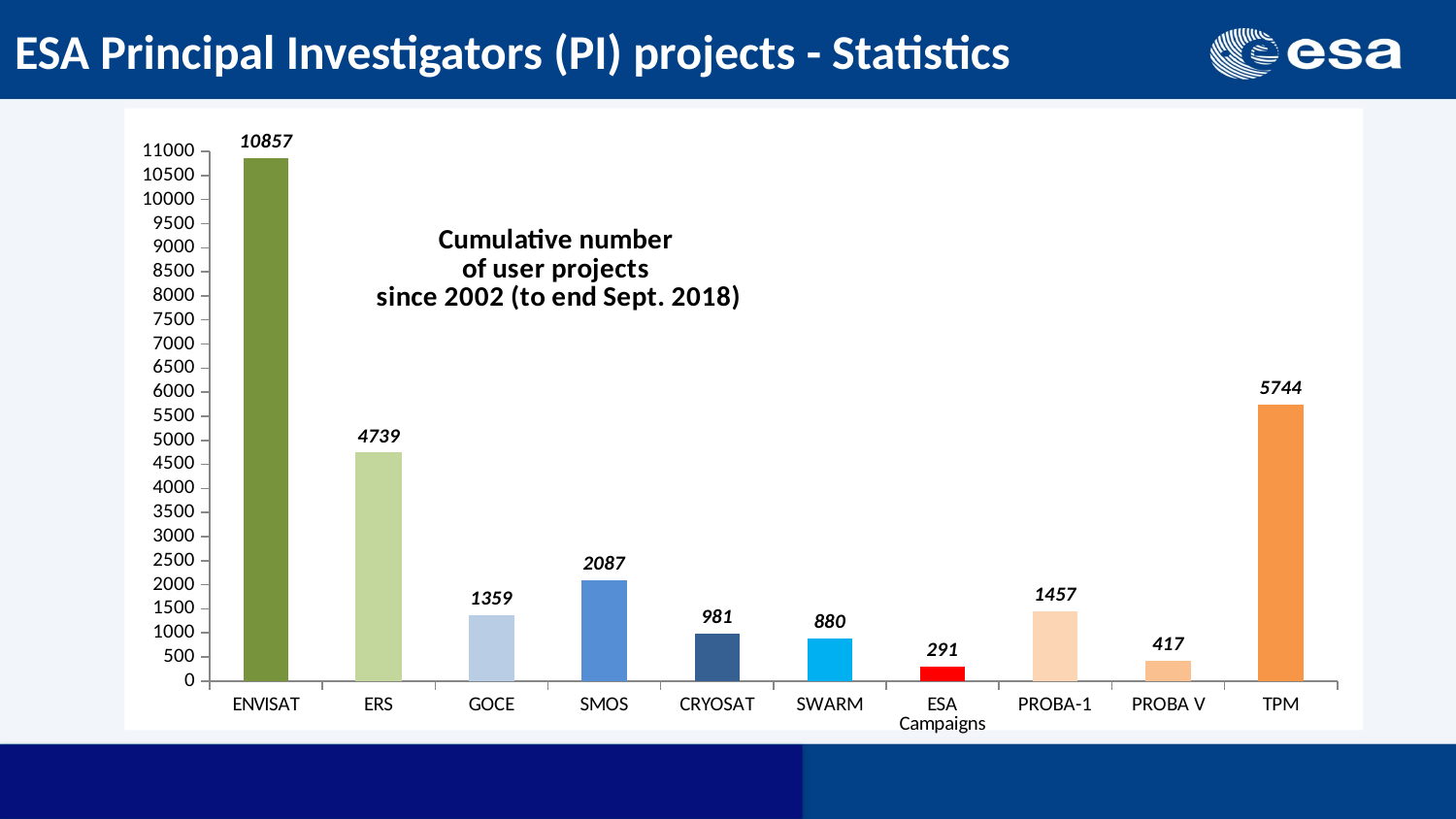
What is the cumulative number of user projects for ENVISAT? 10857 What is the difference between the values for ERS and GOCE? 3380 Is the value for PROBA V greater or less than 500? less Which mission has the highest cumulative number of user projects? ENVISAT What kind of chart is shown on the slide? Bar chart Which category has the lowest value in the chart? ESA Campaigns What is the value shown for TPM? 5744 What is the difference between the values for ENVISAT and TPM? 5113 What is the value shown for ESA Campaigns? 291 How many categories are shown on the x axis of the chart? 10 Which has a larger value, SMOS or CRYOSAT? SMOS What is the value shown for PROBA-1? 1457